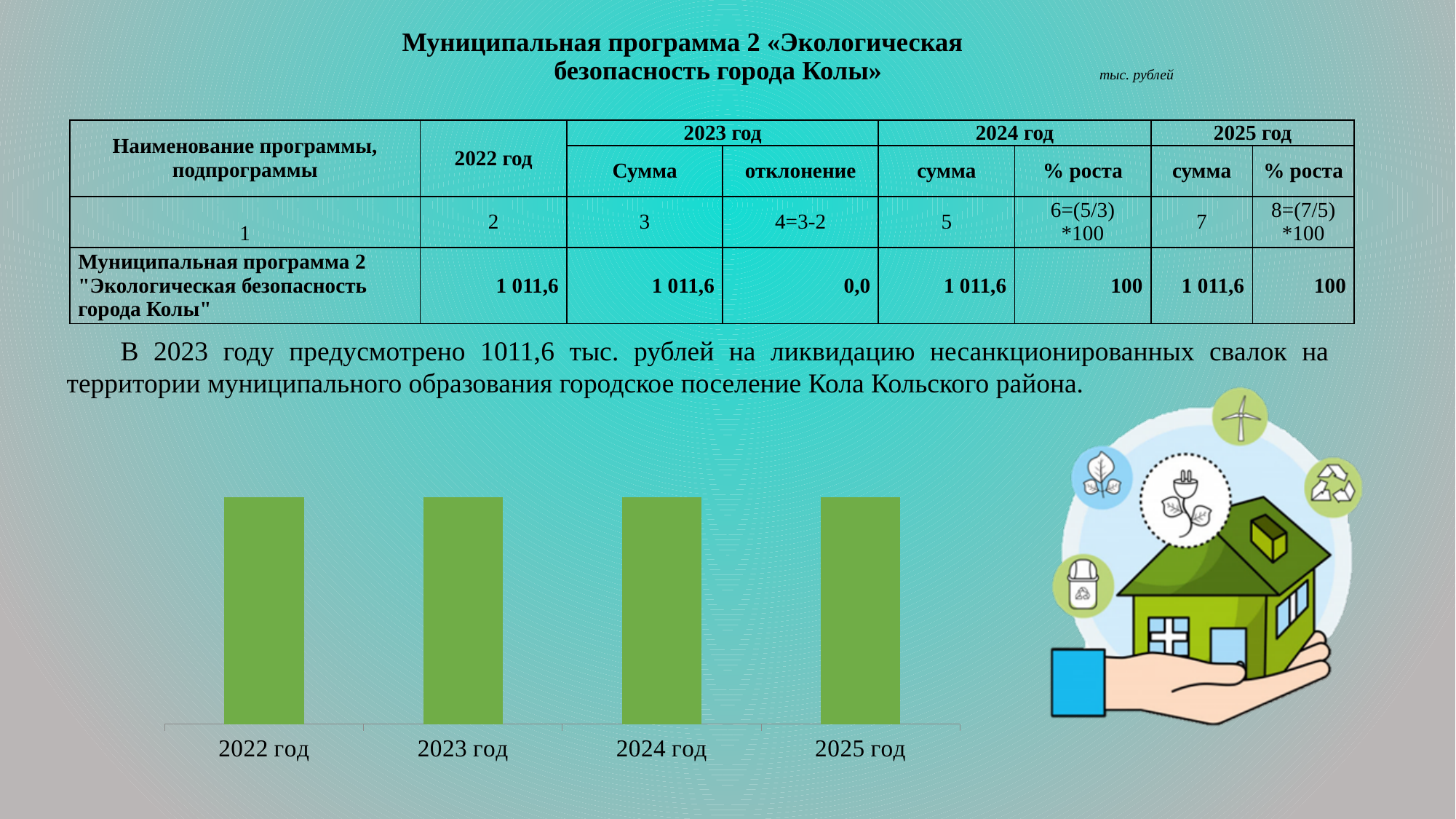
Do the bar heights rise, fall or stay the same from 2022 год to 2025 год? stay the same According to the slide, what is the value for 2023 год (тыс. рублей)? 1 011,6 How many bars does the chart show? 4 What is the label of the first category on the x axis of the chart? 2022 год What is the difference (отклонение) between the 2023 год and 2022 год values shown on the slide? 0,0 According to the slide, what is the value for 2025 год (тыс. рублей)? 1 011,6 According to the slide, what is the value for 2022 год (тыс. рублей)? 1 011,6 What kind of chart is shown at the bottom left of the slide? bar chart Is the bar for 2024 год taller than, shorter than, or the same height as the bar for 2022 год? the same height What colour are the bars in the chart? green